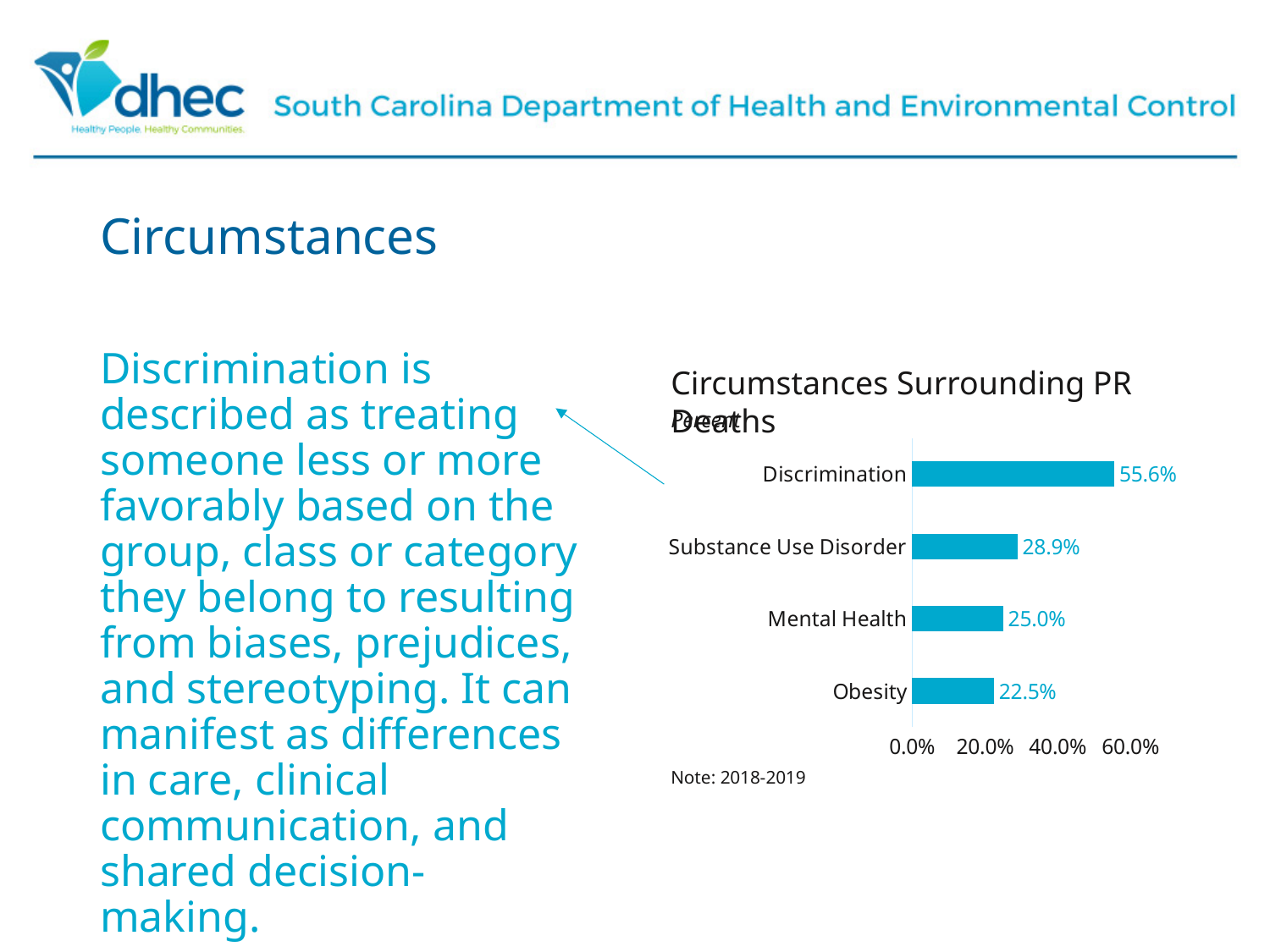
What is the value for Obesity? 22.5% Is the value for Discrimination greater or less than 40.0%? greater How many categories are shown in the chart? 4 What is the value for Substance Use Disorder? 28.9% Which category has the lowest value? Obesity What is the difference between the values for Discrimination and Substance Use Disorder? 26.7% Which is larger, the value for Substance Use Disorder or the value for Mental Health? Substance Use Disorder Which category has the highest value? Discrimination What is the difference between the values for Mental Health and Obesity? 2.5% What kind of chart is shown on the slide? Bar chart What is the value for Mental Health? 25.0% What is the value for Discrimination? 55.6%